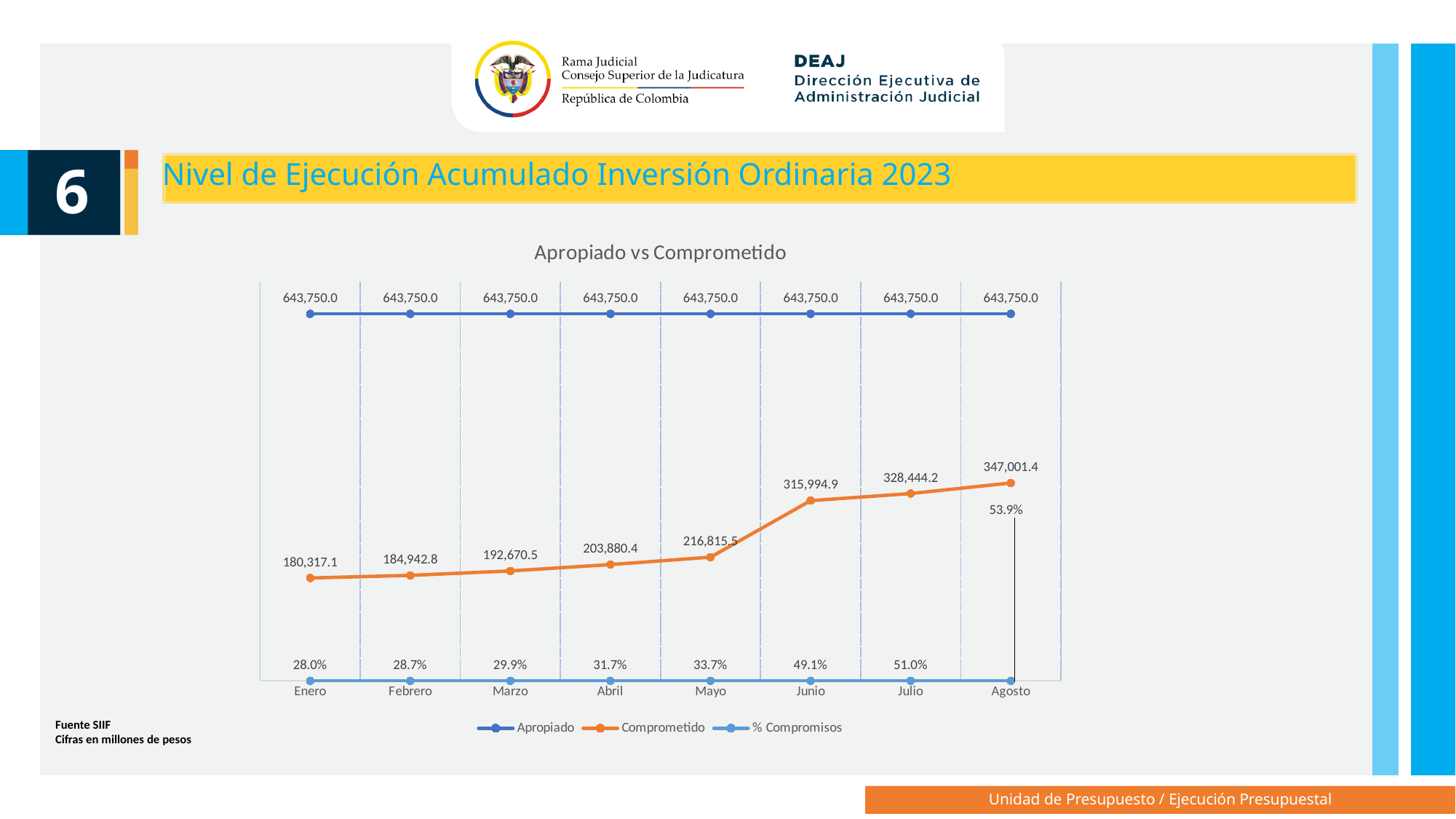
What is the Apropiado value for Marzo? 643,750.0 Does the Comprometido series rise or fall from Enero to Agosto? Rise What is the difference between the Comprometido values for Agosto and Julio? 18,557.2 What kind of chart is this? Line chart How many months are shown on the x axis? 8 Which is larger, the Comprometido value for Mayo or for Junio? Junio In which month is the Comprometido value highest? Agosto In which month is the Comprometido value lowest? Enero How many series does the legend list? 3 What is the % Compromisos value for Junio? 49.1% What is the Comprometido value for Enero? 180,317.1 What is the Comprometido value for Agosto? 347,001.4